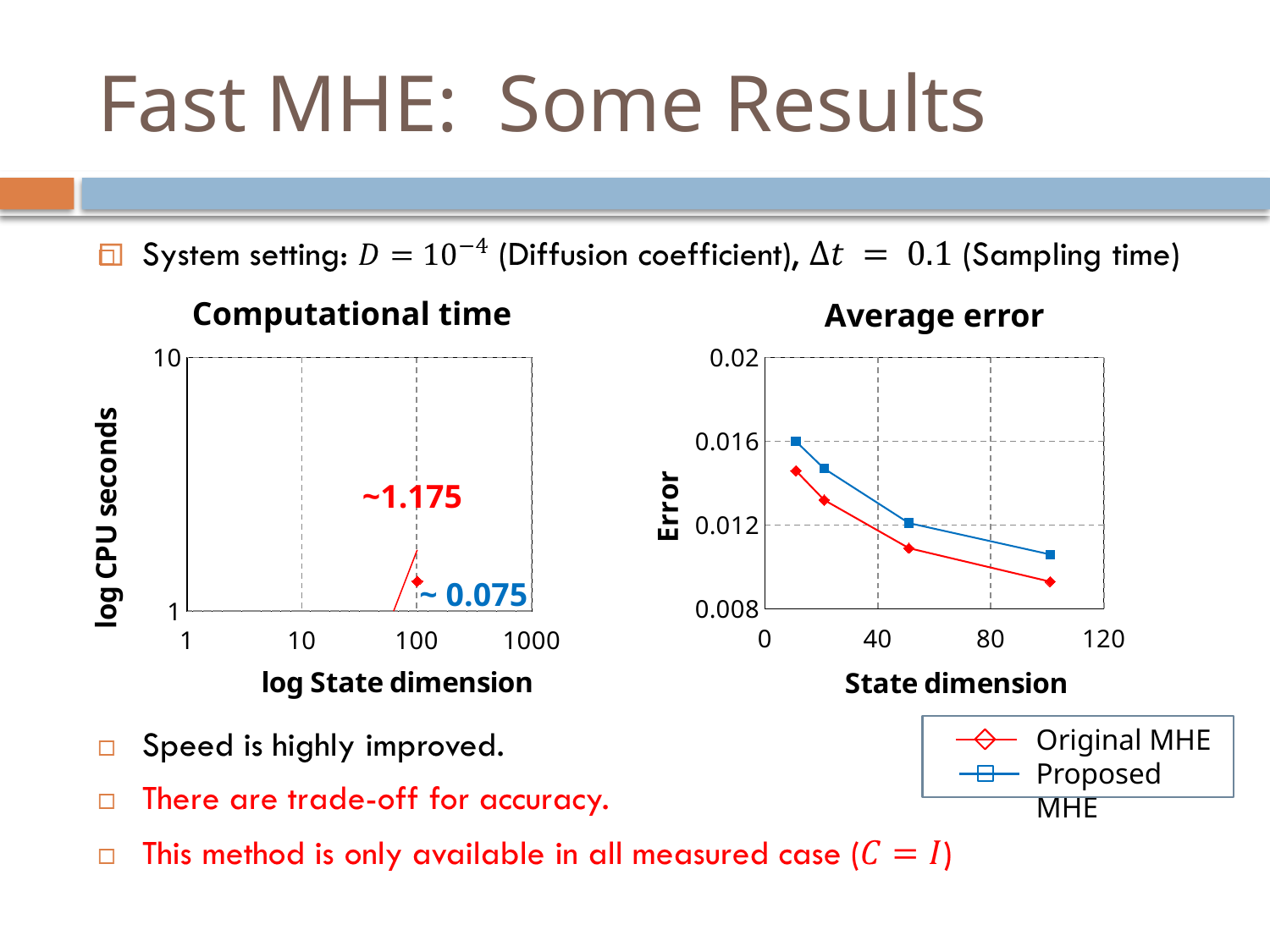
What colour is the line for Proposed MHE in the Average error chart? blue In the Average error chart, how many data points are plotted for the Proposed MHE series? 4 In the Average error chart, does the error for Proposed MHE rise or fall as state dimension increases? fall In the Average error chart, which series has the higher error at state dimension 100, Original MHE or Proposed MHE? Proposed MHE In the Average error chart, is the error for Original MHE at state dimension 100 greater or less than 0.012? less In the Average error chart, how many series does the legend list? 2 In the Average error chart, is the error for Proposed MHE at its smallest state dimension greater or less than 0.012? greater What is the label of the y axis of the Computational time chart? log CPU seconds In the Average error chart, which series reaches the lowest error value? Original MHE In the Average error chart, what kind of chart is shown? line chart In the Average error chart, is the error for Original MHE at its smallest state dimension greater or less than 0.016? less In the Average error chart, does the error for Original MHE rise or fall as state dimension increases? fall